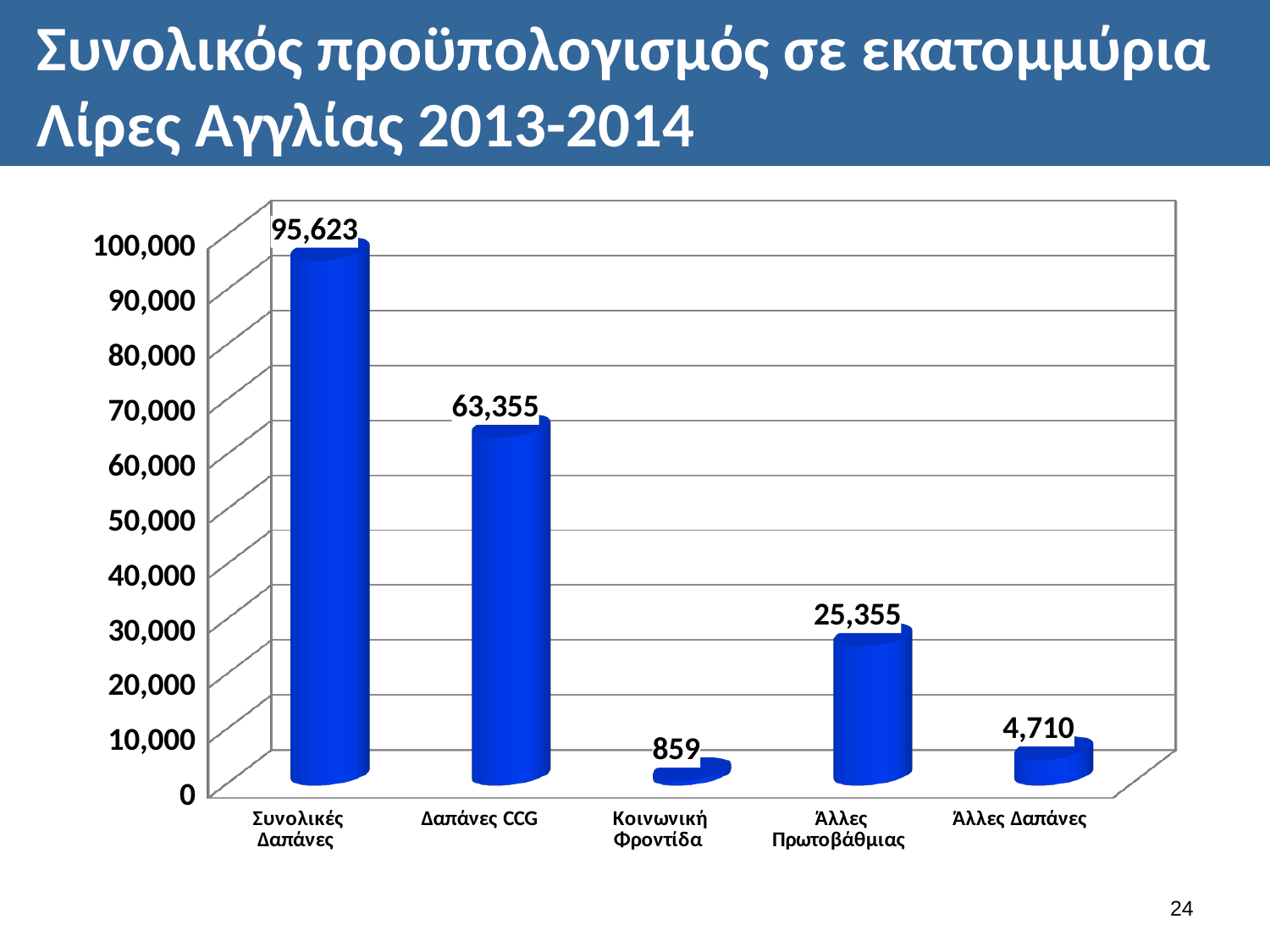
Which is larger, the value for Άλλες Πρωτοβάθμιας or the value for Άλλες Δαπάνες? Άλλες Πρωτοβάθμιας What is the value for Άλλες Δαπάνες? 4,710 What is the difference between the values for Δαπάνες CCG and Άλλες Πρωτοβάθμιας? 38,000 What is the value for Δαπάνες CCG? 63,355 What kind of chart is shown on the slide? Bar chart Which category has the highest value? Συνολικές Δαπάνες What is the value for Κοινωνική Φροντίδα? 859 What is the difference between the values for Συνολικές Δαπάνες and Δαπάνες CCG? 32,268 What is the value for Άλλες Πρωτοβάθμιας? 25,355 What is the value for Συνολικές Δαπάνες? 95,623 Which category has the lowest value? Κοινωνική Φροντίδα How many categories are shown on the chart? 5